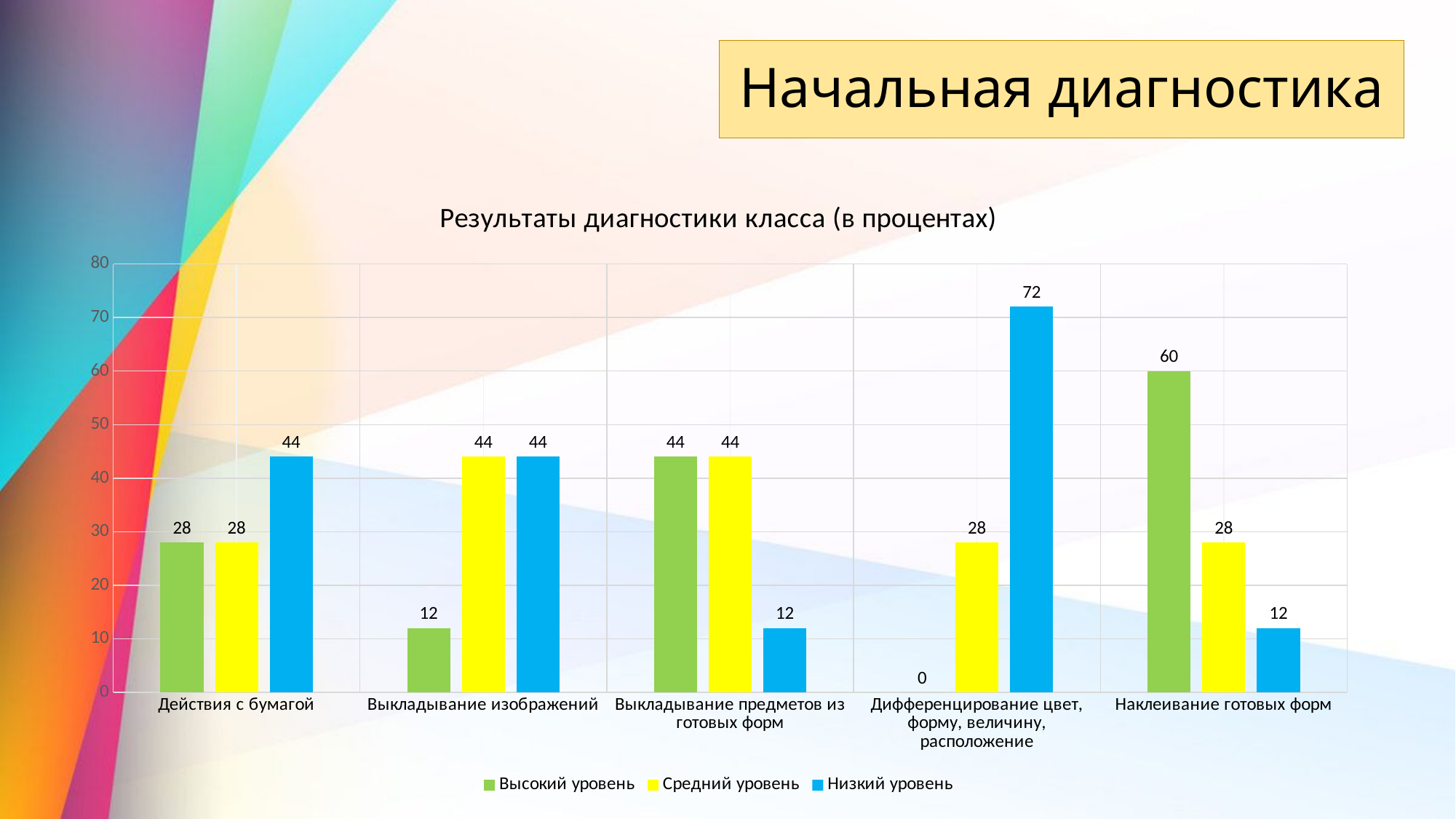
Which category has the lowest value for Высокий уровень? Дифференцирование цвет, форму, величину, расположение How many series does the legend list? 3 How many categories are shown on the x axis? 5 Which category has the highest value for Низкий уровень? Дифференцирование цвет, форму, величину, расположение What is the title of the chart? Результаты диагностики класса (в процентах) What kind of chart is shown on the slide? Bar chart What is the difference between the Низкий уровень value and the Средний уровень value in the Дифференцирование цвет, форму, величину, расположение category? 44 What is the value for Высокий уровень in the Наклеивание готовых форм category? 60 What is the value for Низкий уровень in the Дифференцирование цвет, форму, величину, расположение category? 72 In the Наклеивание готовых форм category, which is larger: Высокий уровень or Низкий уровень? Высокий уровень What is the value for Высокий уровень in the Дифференцирование цвет, форму, величину, расположение category? 0 What is the value for Высокий уровень in the Выкладывание изображений category? 12